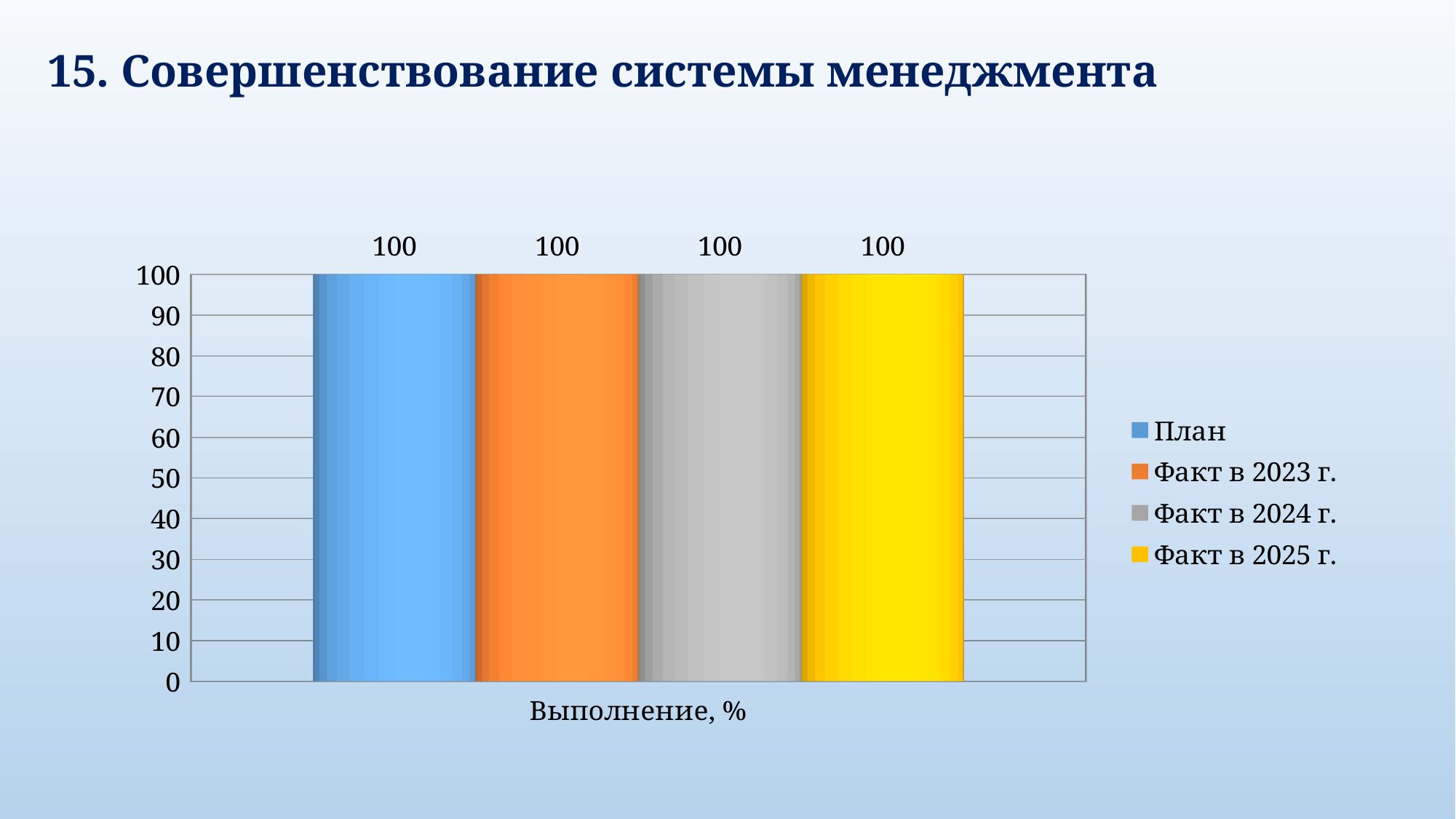
What is the label of the category on the x axis? Выполнение, % What is the value of the Факт в 2023 г. bar? 100 How many categories are shown on the x axis? 1 What colour is the Факт в 2025 г. bar? yellow What is the value of the Факт в 2024 г. bar? 100 What kind of chart is shown on the slide? bar chart How many series does the legend list? 4 What is the difference between the План value and the Факт в 2025 г. value? 0 What is the value of the План bar? 100 Is the value for Факт в 2024 г. greater or less than 50? greater What is the value of the Факт в 2025 г. bar? 100 What is the highest value shown on the y axis? 100